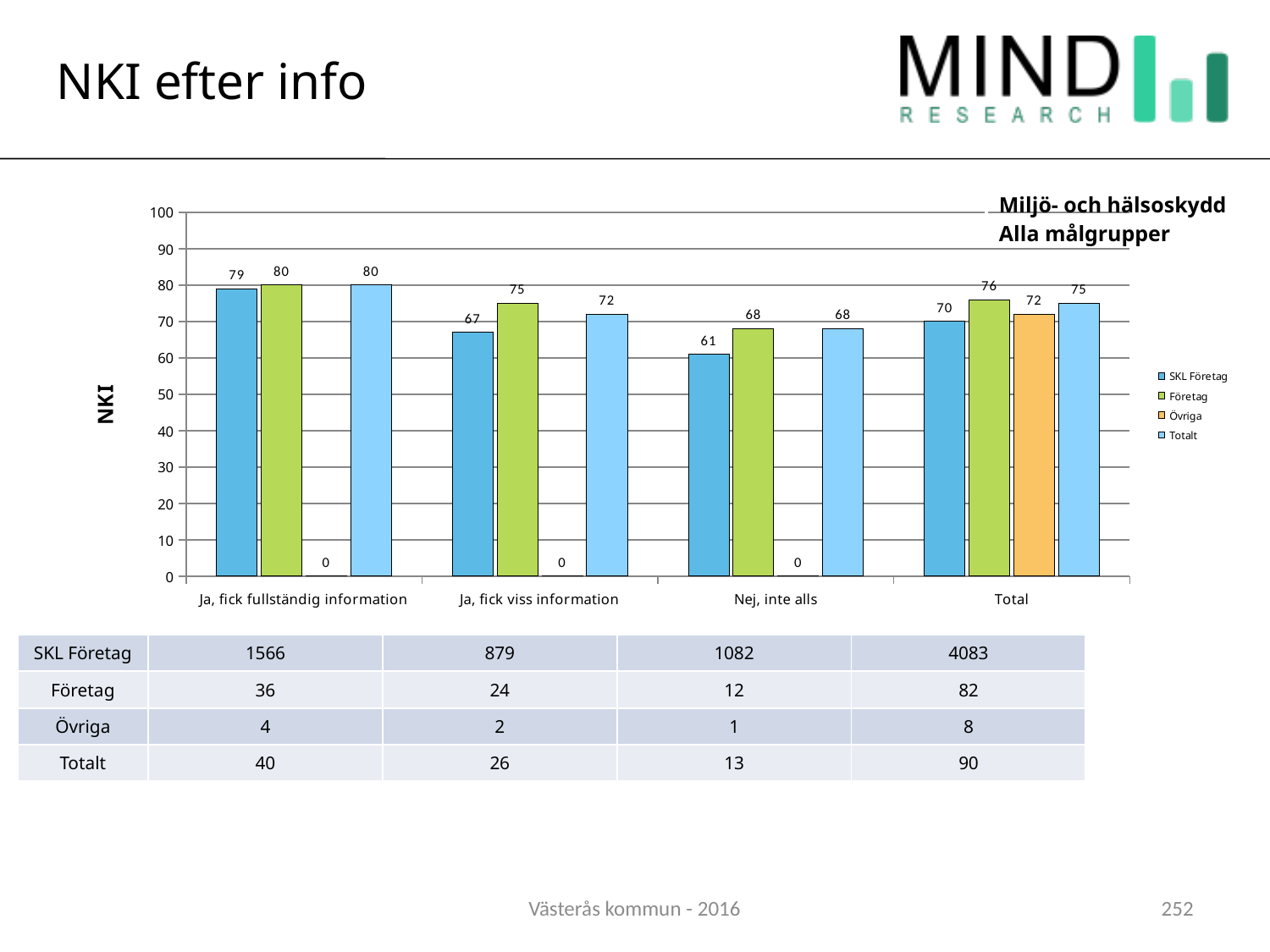
What is the NKI value for Övriga in the 'Total' category? 72 Which is larger in the 'Total' category: the value for Företag or the value for Totalt? Företag What type of chart is shown on the slide? Bar chart What is the NKI value for Totalt in the category 'Ja, fick viss information'? 72 How many series does the chart legend list? 4 Which category has the lowest NKI value for SKL Företag? Nej, inte alls How many categories are shown on the x axis of the chart? 4 What is the NKI value for Företag in the category 'Nej, inte alls'? 68 Which category has the highest NKI value for Företag? Ja, fick fullständig information What is the difference between the Företag value and the SKL Företag value in the category 'Ja, fick viss information'? 8 What is the label of the y axis of the chart? NKI What is the NKI value for SKL Företag in the category 'Ja, fick fullständig information'? 79